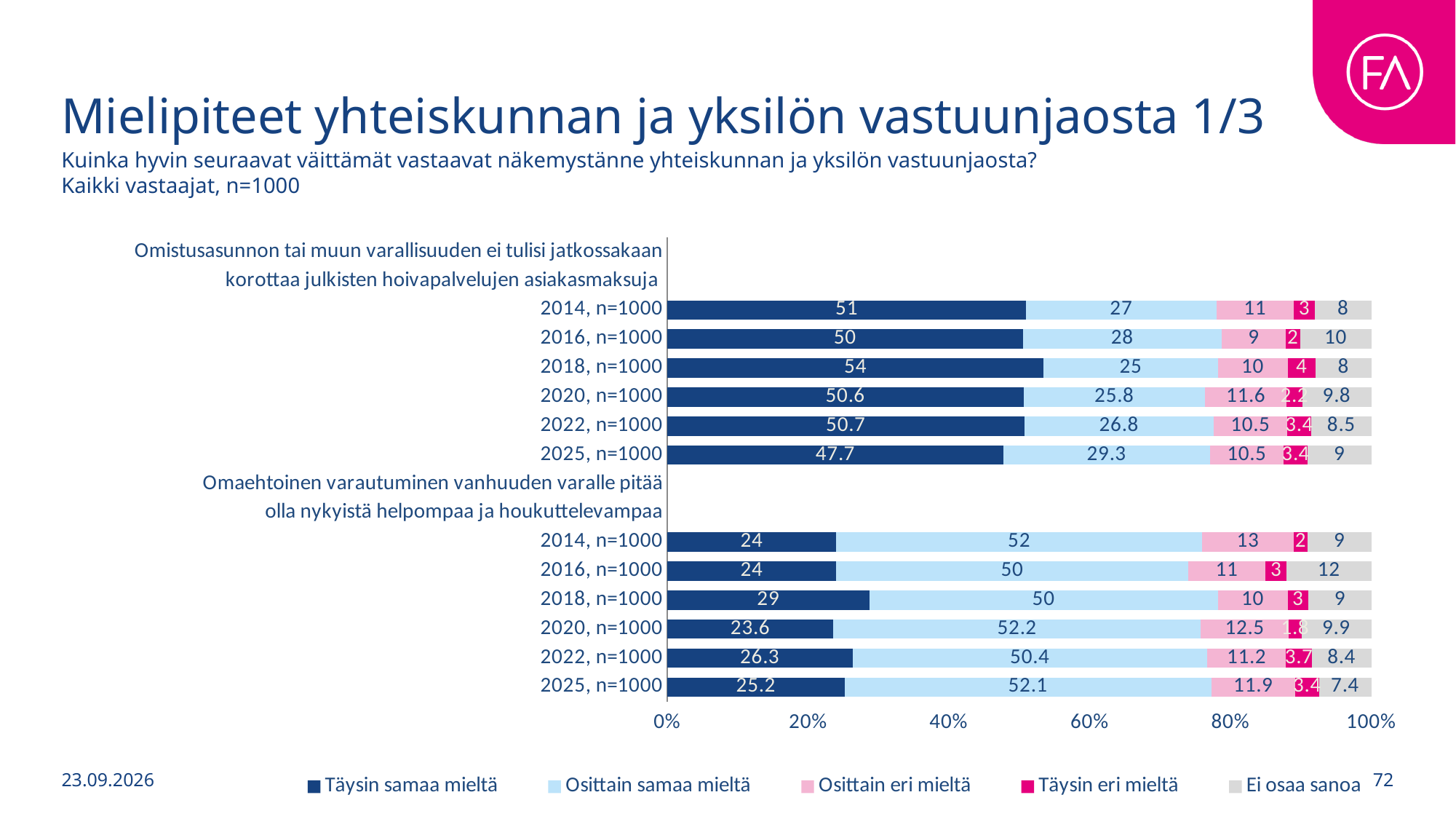
What is the difference between the "Täysin samaa mieltä" values for 2018 and 2025 under the statement "Omistusasunnon tai muun varallisuuden ei tulisi jatkossakaan korottaa julkisten hoivapalvelujen asiakasmaksuja"? 6.3 Under the statement "Omaehtoinen varautuminen vanhuuden varalle pitää olla nykyistä helpompaa ja houkuttelevampaa", which year has the highest "Täysin samaa mieltä" value? 2018, n=1000 What kind of chart is shown on the slide? Stacked bar chart Under the statement "Omistusasunnon tai muun varallisuuden ei tulisi jatkossakaan korottaa julkisten hoivapalvelujen asiakasmaksuja", which year has the lowest "Täysin samaa mieltä" value? 2025, n=1000 Under the statement "Omistusasunnon tai muun varallisuuden ei tulisi jatkossakaan korottaa julkisten hoivapalvelujen asiakasmaksuja", which year has the highest "Täysin samaa mieltä" value? 2018, n=1000 What is the value for "Osittain samaa mieltä" in the 2025, n=1000 bar under the statement "Omaehtoinen varautuminen vanhuuden varalle pitää olla nykyistä helpompaa ja houkuttelevampaa"? 52.1 Under the statement "Omaehtoinen varautuminen vanhuuden varalle pitää olla nykyistä helpompaa ja houkuttelevampaa", which year has the larger "Ei osaa sanoa" value, 2014 or 2016? 2016, n=1000 How many year bars are shown under each statement? 6 How many series does the legend list? 5 What is the value for "Osittain eri mieltä" in the 2020, n=1000 bar under the statement "Omaehtoinen varautuminen vanhuuden varalle pitää olla nykyistä helpompaa ja houkuttelevampaa"? 12.5 What is the value for "Täysin samaa mieltä" in the 2018, n=1000 bar under the statement "Omistusasunnon tai muun varallisuuden ei tulisi jatkossakaan korottaa julkisten hoivapalvelujen asiakasmaksuja"? 54 What is the value for "Ei osaa sanoa" in the 2025, n=1000 bar under the statement "Omaehtoinen varautuminen vanhuuden varalle pitää olla nykyistä helpompaa ja houkuttelevampaa"? 7.4